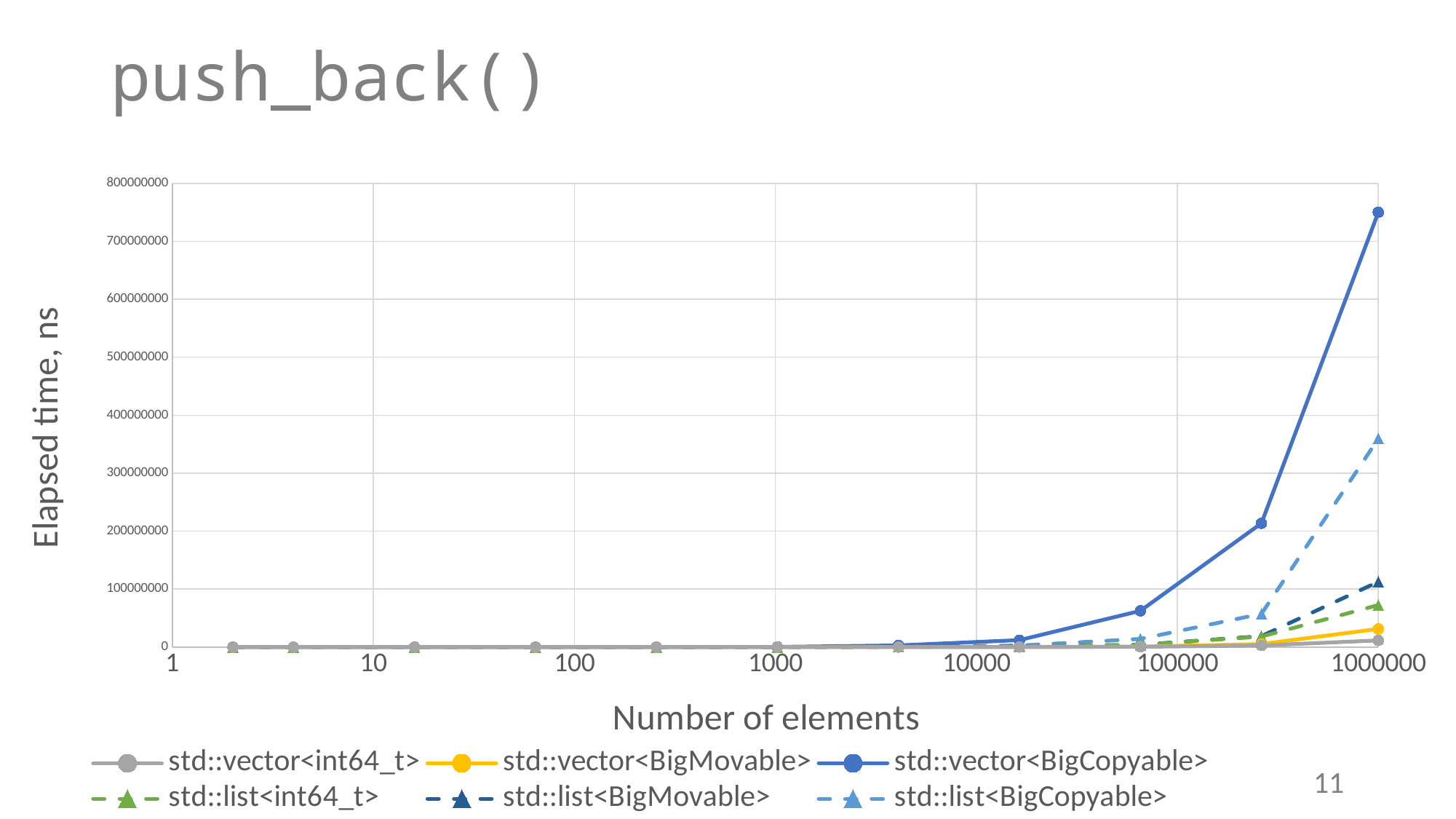
What kind of chart is shown on the slide? line chart Which series has the highest elapsed time at 1000000 elements? std::vector<BigCopyable> Is the value for std::vector<BigCopyable> at 1000000 elements greater or less than 700000000? greater At 1000000 elements, which is larger: std::vector<BigCopyable> or std::list<BigCopyable>? std::vector<BigCopyable> Is the value for std::list<BigCopyable> at 1000000 elements greater or less than 400000000? less What is the title of the chart? push_back() Is the value for std::list<BigCopyable> at 1000000 elements greater or less than 300000000? greater At 1000000 elements, which is larger: std::list<int64_t> or std::vector<BigMovable>? std::list<int64_t> Does the elapsed time for std::vector<BigCopyable> rise or fall as the number of elements increases? rise How many series does the legend list? 6 What is the label of the y axis? Elapsed time, ns